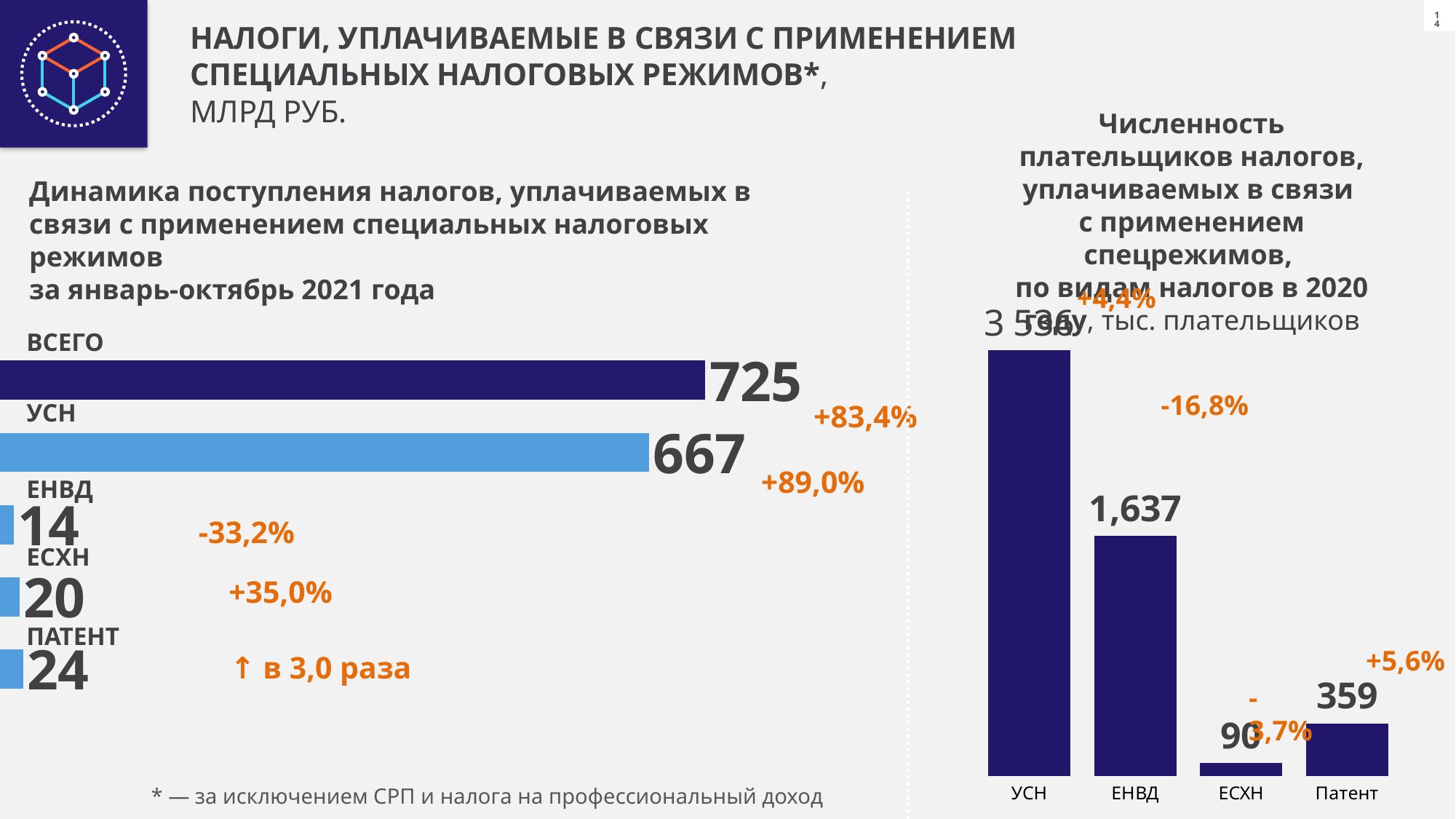
On the left chart, what is the value for ПАТЕНТ? 24 What kind of chart is the left chart? bar chart On the right chart, which category has the highest value? УСН On the left chart, what is the value for ЕНВД? 14 On the left chart, how many bars are shown? 5 On the right chart, what is the value for ЕНВД? 1,637 On the left chart, what is the difference between ВСЕГО and УСН? 58 On the right chart, what is the value for Патент? 359 On the left chart, what is the value for ВСЕГО? 725 On the left chart, what is the value for УСН? 667 On the left chart, which is larger, ЕСХН or ПАТЕНТ? ПАТЕНТ On the left chart, which category has the lowest value? ЕНВД